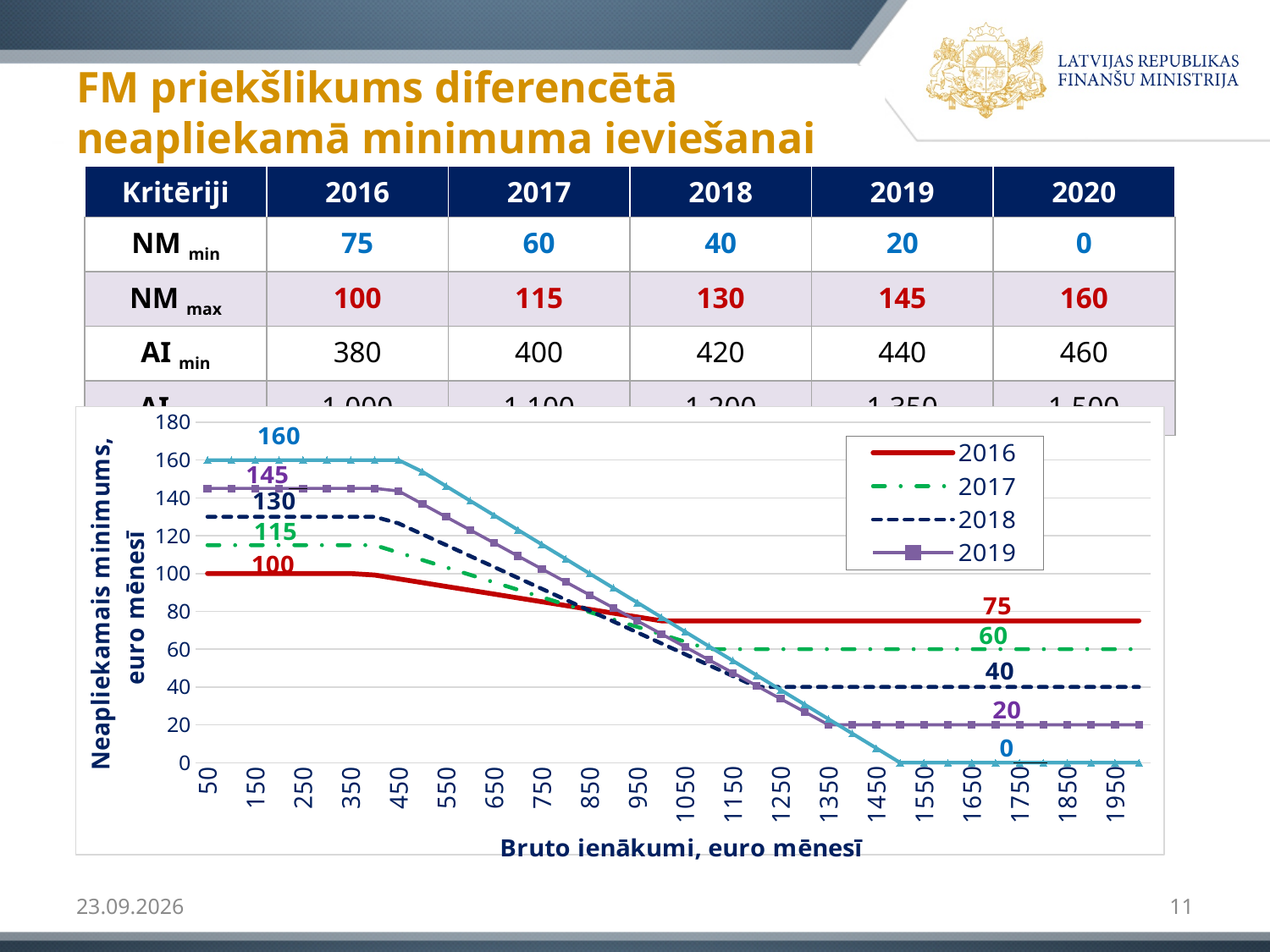
What kind of chart is shown on the slide? line chart What is the difference between the labelled high value (145) and low value (20) of the 2019 line? 125 What is the labelled value of the 2018 line at the highest income levels? 40 What is the labelled value of the 2019 line at the lowest income levels? 145 How many series does the chart legend list? 4 What is the title of the x axis? Bruto ienākumi, euro mēnesī What is the labelled value of the 2016 line at the highest income levels? 75 What is the labelled value of the 2016 line at the lowest income levels? 100 Among the series listed in the legend, which has the lowest value at a gross income of 1950 euro? 2019 Is the value of the 2018 line at a gross income of 1950 euro greater or less than 60? less At a gross income of 50 euro, which line is higher: 2016 or 2019? 2019 Do the lines rise or fall as gross income increases along the x axis? fall